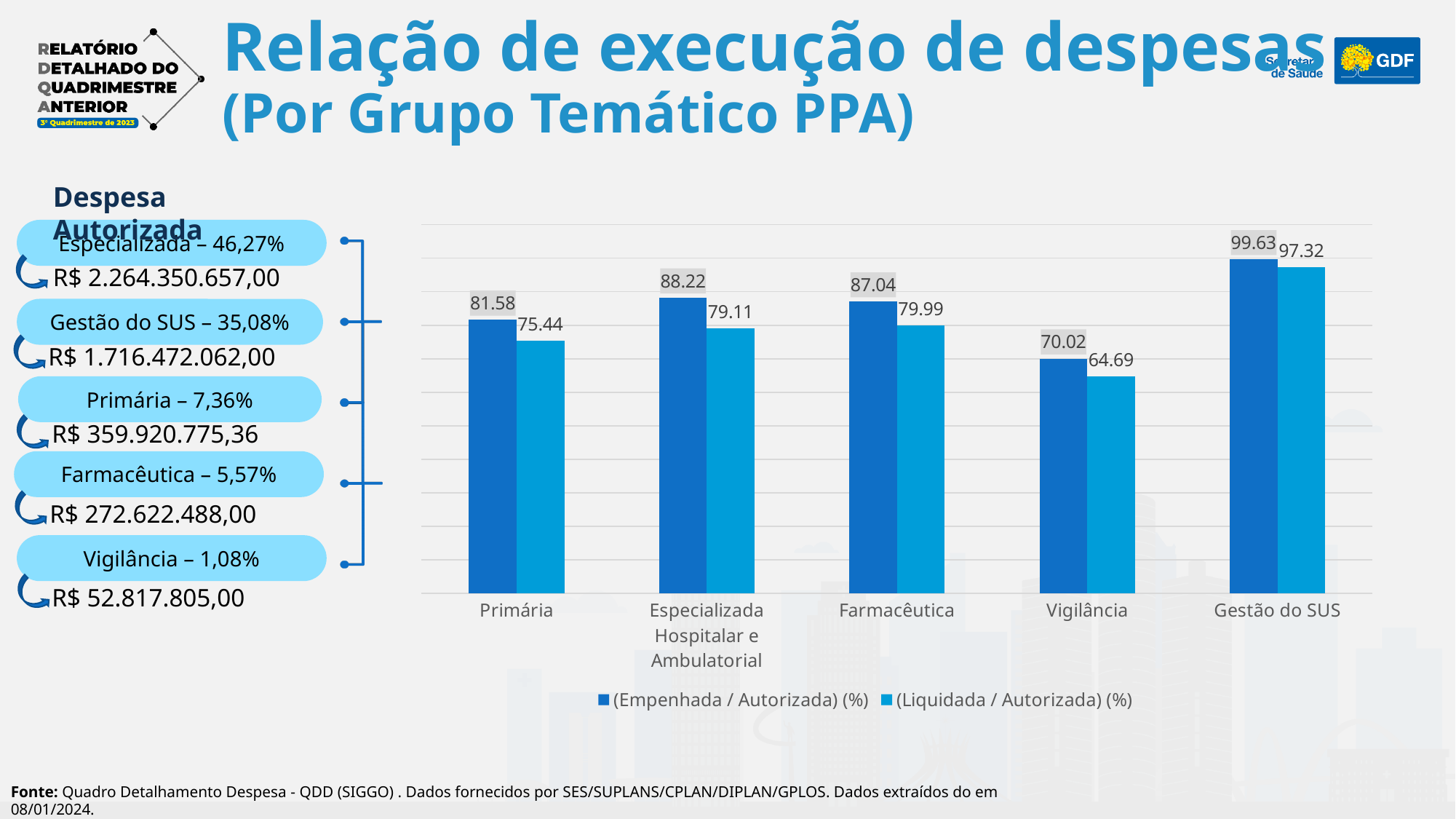
What is the difference between the (Empenhada / Autorizada) (%) and (Liquidada / Autorizada) (%) values for Farmacêutica? 7.05 How many series does the chart legend list? 2 What is the difference between the (Empenhada / Autorizada) (%) and (Liquidada / Autorizada) (%) values for Gestão do SUS? 2.31 What is the (Liquidada / Autorizada) (%) value for Especializada Hospitalar e Ambulatorial? 79.11 Which is larger: the (Liquidada / Autorizada) (%) value for Primária or for Farmacêutica? Farmacêutica Which category has the highest (Empenhada / Autorizada) (%) value? Gestão do SUS What is the (Empenhada / Autorizada) (%) value for Primária? 81.58 How many categories are shown on the x axis of the chart? 5 Which category has the lowest (Liquidada / Autorizada) (%) value? Vigilância What is the (Liquidada / Autorizada) (%) value for Vigilância? 64.69 What is the (Empenhada / Autorizada) (%) value for Gestão do SUS? 99.63 What kind of chart is shown on the slide? Bar chart